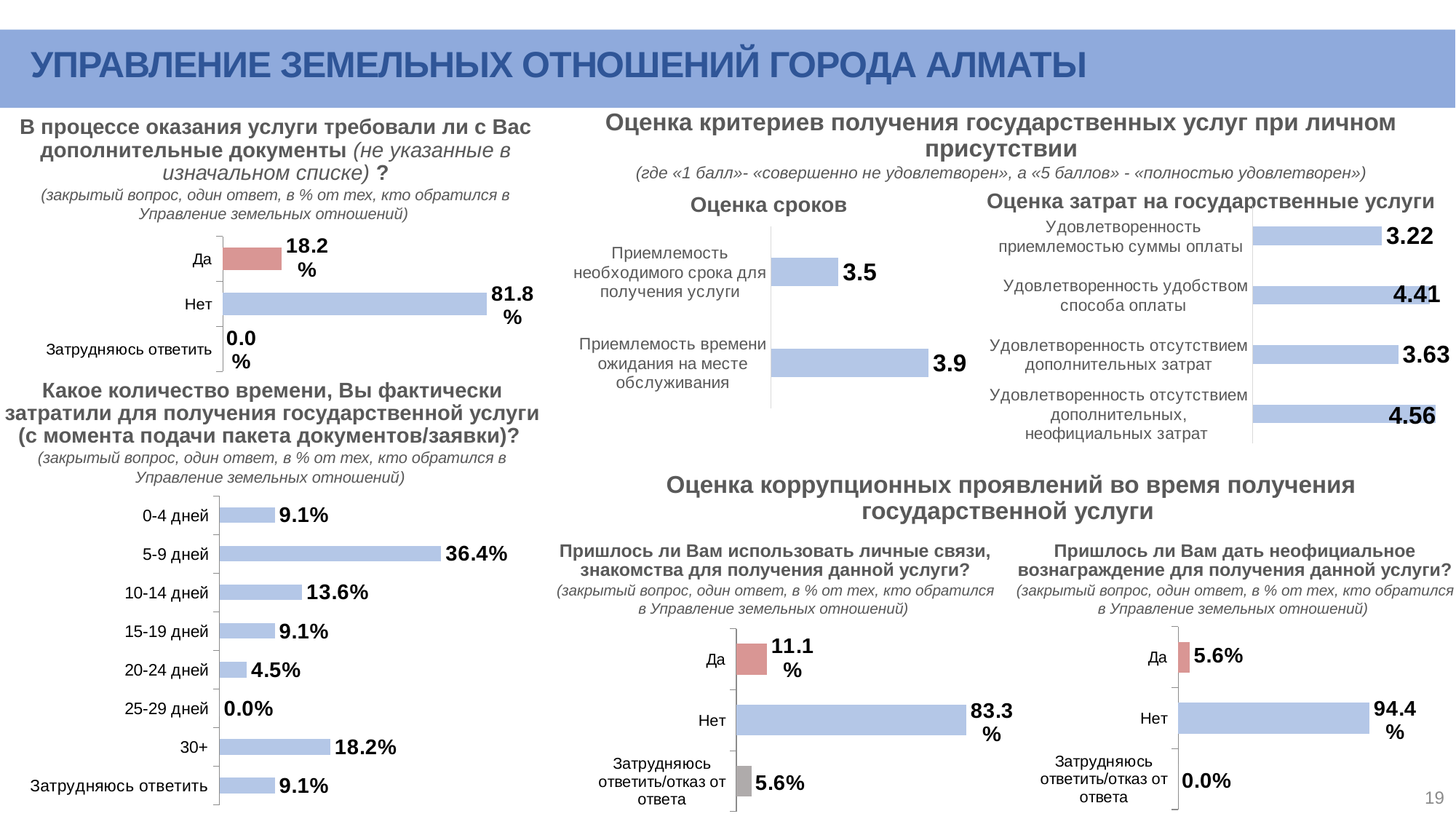
In the chart 'Какое количество времени, Вы фактически затратили для получения государственной услуги', what is the value for '5-9 дней'? 36.4% In the chart 'Оценка затрат на государственные услуги', which category has the lowest value? Удовлетворенность приемлемостью суммы оплаты In the chart 'Пришлось ли Вам дать неофициальное вознаграждение для получения данной услуги?', which is larger, the value for 'Да' or the value for 'Нет'? Нет In the chart 'Оценка затрат на государственные услуги', what is the difference between the values for 'Удовлетворенность отсутствием дополнительных, неофициальных затрат' and 'Удовлетворенность отсутствием дополнительных затрат'? 0.93 In the chart 'В процессе оказания услуги требовали ли с Вас дополнительные документы', what is the value for 'Нет'? 81.8% In the chart 'Оценка сроков', what is the value for 'Приемлемость времени ожидания на месте обслуживания'? 3.9 In the chart 'Какое количество времени, Вы фактически затратили для получения государственной услуги', how many categories are shown? 8 In the chart 'Какое количество времени, Вы фактически затратили для получения государственной услуги', which category has the highest value? 5-9 дней In the chart 'Оценка затрат на государственные услуги', what is the value for 'Удовлетворенность удобством способа оплаты'? 4.41 In the chart 'Какое количество времени, Вы фактически затратили для получения государственной услуги', what is the difference between the values for '30+' and '10-14 дней'? 4.6% In the chart 'Пришлось ли Вам использовать личные связи, знакомства для получения данной услуги?', what is the value for 'Да'? 11.1% What type of chart is 'Оценка сроков'? Bar chart